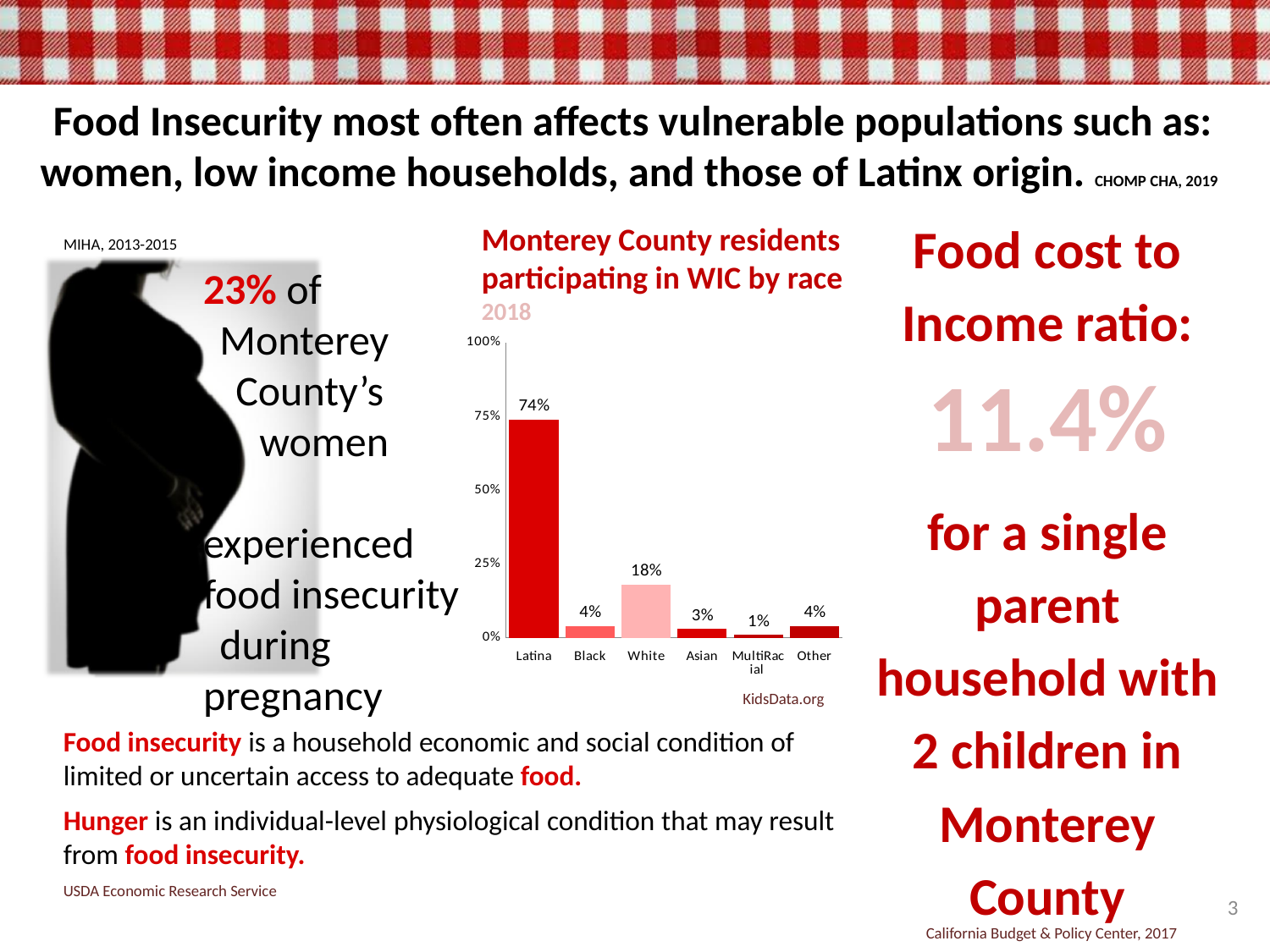
Which is larger, the value for Black or the value for Asian? Black Which race category has the highest share of WIC participants? Latina What percentage of Monterey County residents participating in WIC are Latina? 74% What is the value shown for the Asian category? 3% What is the value shown for the MultiRacial category? 1% What year does the WIC participation chart cover? 2018 Is the value for Latina greater or less than 50%? greater How many race categories are shown in the WIC participation chart? 6 What is the difference between the Latina and White values in the WIC chart? 56% What is the value shown for the White category in the WIC participation chart? 18% Which race category has the lowest share of WIC participants? MultiRacial What kind of chart is used to show Monterey County residents participating in WIC by race? Bar chart